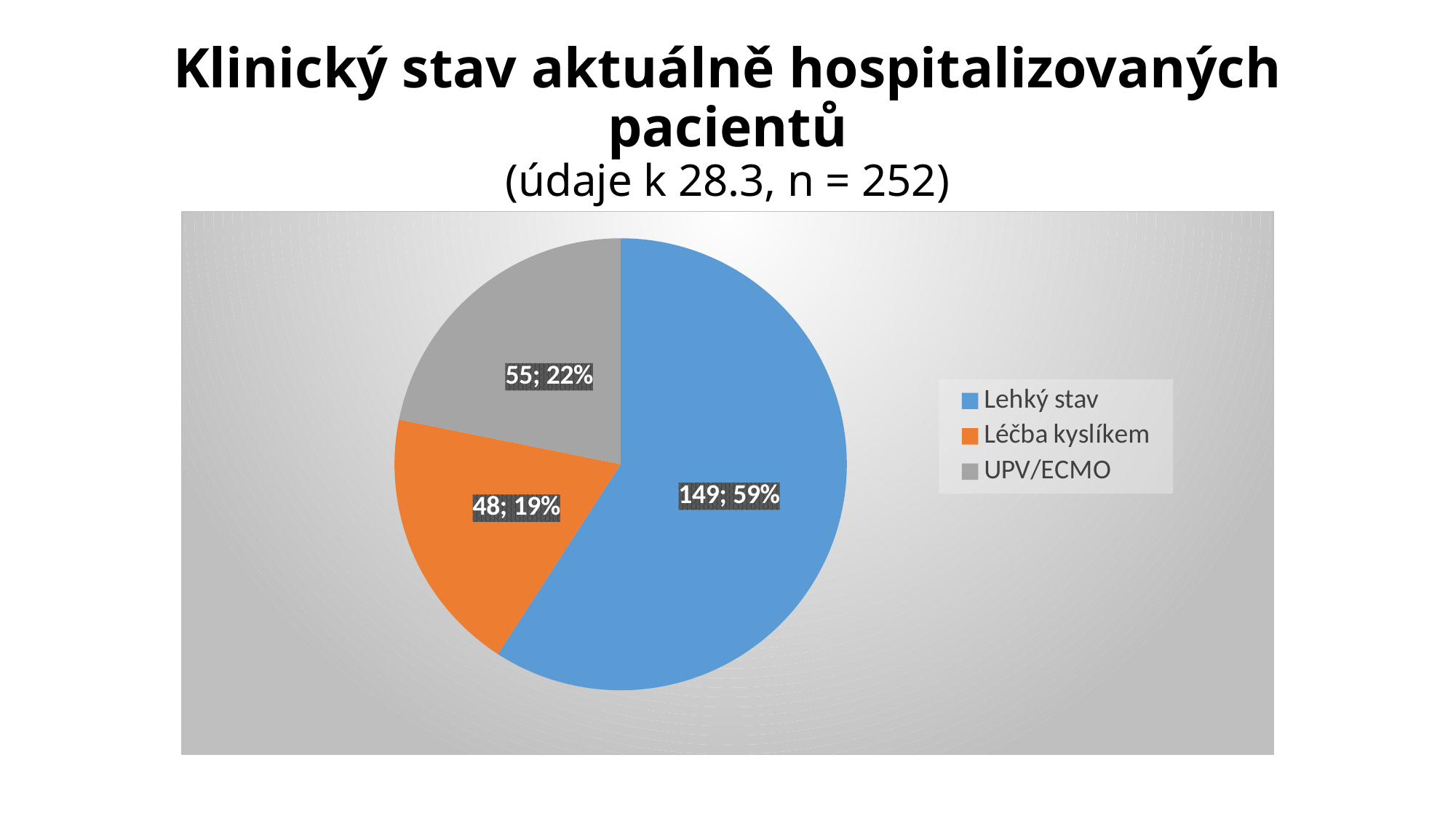
How many patients are in the 'Lehký stav' category? 149 What is the difference in patient count between 'Lehký stav' and 'UPV/ECMO'? 94 How many categories does the pie chart have? 3 Which category has the smallest slice of the pie? Léčba kyslíkem What colour is the 'Léčba kyslíkem' slice? Orange Which category has the largest slice of the pie? Lehký stav What type of chart is shown on the slide? Pie chart Which has more patients, 'UPV/ECMO' or 'Léčba kyslíkem'? UPV/ECMO How many patients are in the 'Léčba kyslíkem' category? 48 How many patients are in the 'UPV/ECMO' category? 55 What share of the pie does 'Lehký stav' represent? 59% What share of the pie does 'UPV/ECMO' represent? 22%